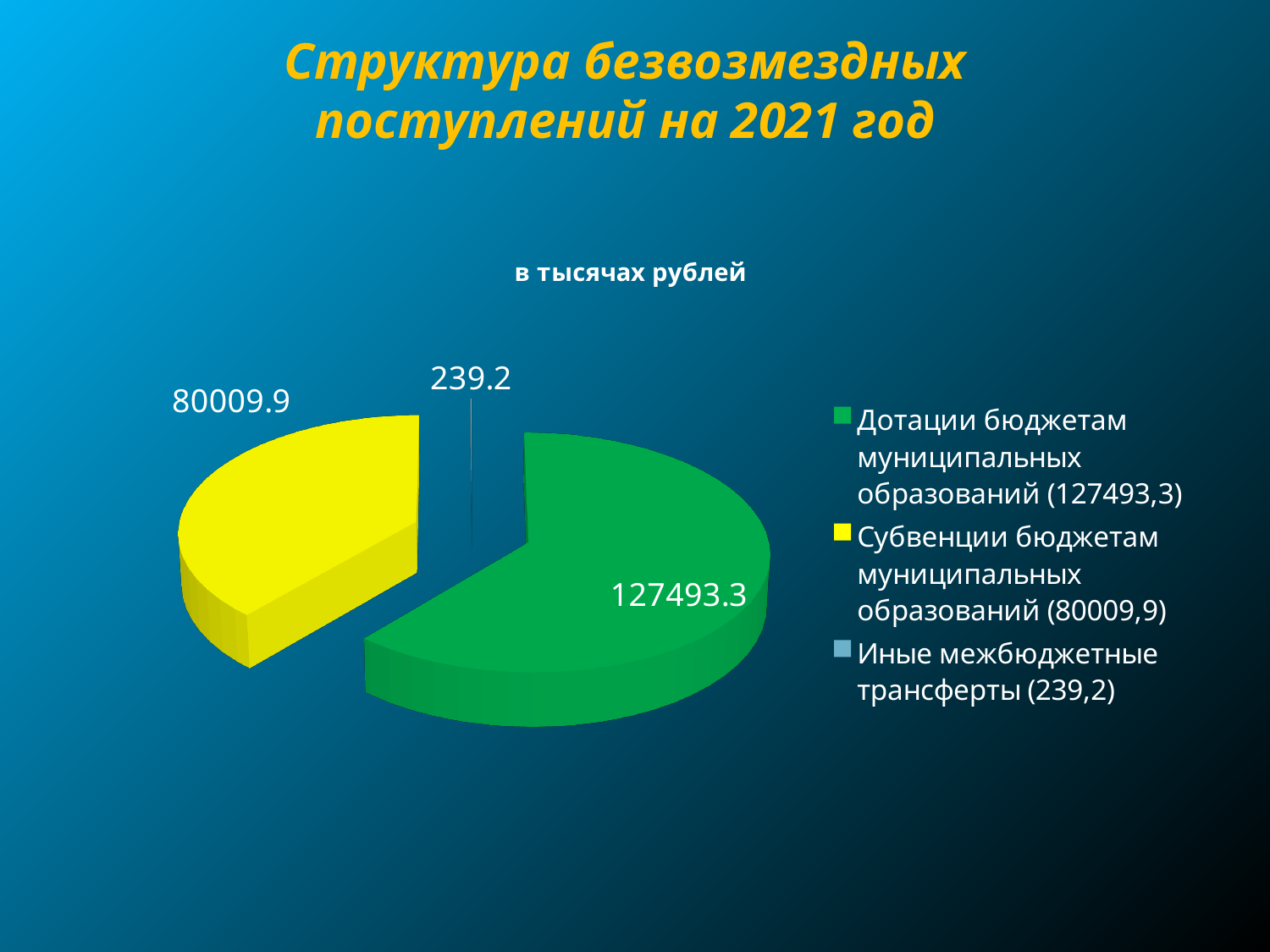
How many slices does the pie chart have? 3 Which category has the largest slice of the pie? Дотации бюджетам муниципальных образований What unit is stated in the chart title above the pie? в тысячах рублей How many entries does the legend list? 3 What is the value for Субвенции бюджетам муниципальных образований? 80009.9 What kind of chart is shown on the slide? Pie chart Which category has the smallest slice of the pie? Иные межбюджетные трансферты What is the value for Дотации бюджетам муниципальных образований? 127493.3 Which is larger: Субвенции бюджетам муниципальных образований or Иные межбюджетные трансферты? Субвенции бюджетам муниципальных образований What is the total of all three slices of the pie? 207742.4 What is the difference between the values for Дотации бюджетам муниципальных образований and Субвенции бюджетам муниципальных образований? 47483.4 What is the value for Иные межбюджетные трансферты? 239.2